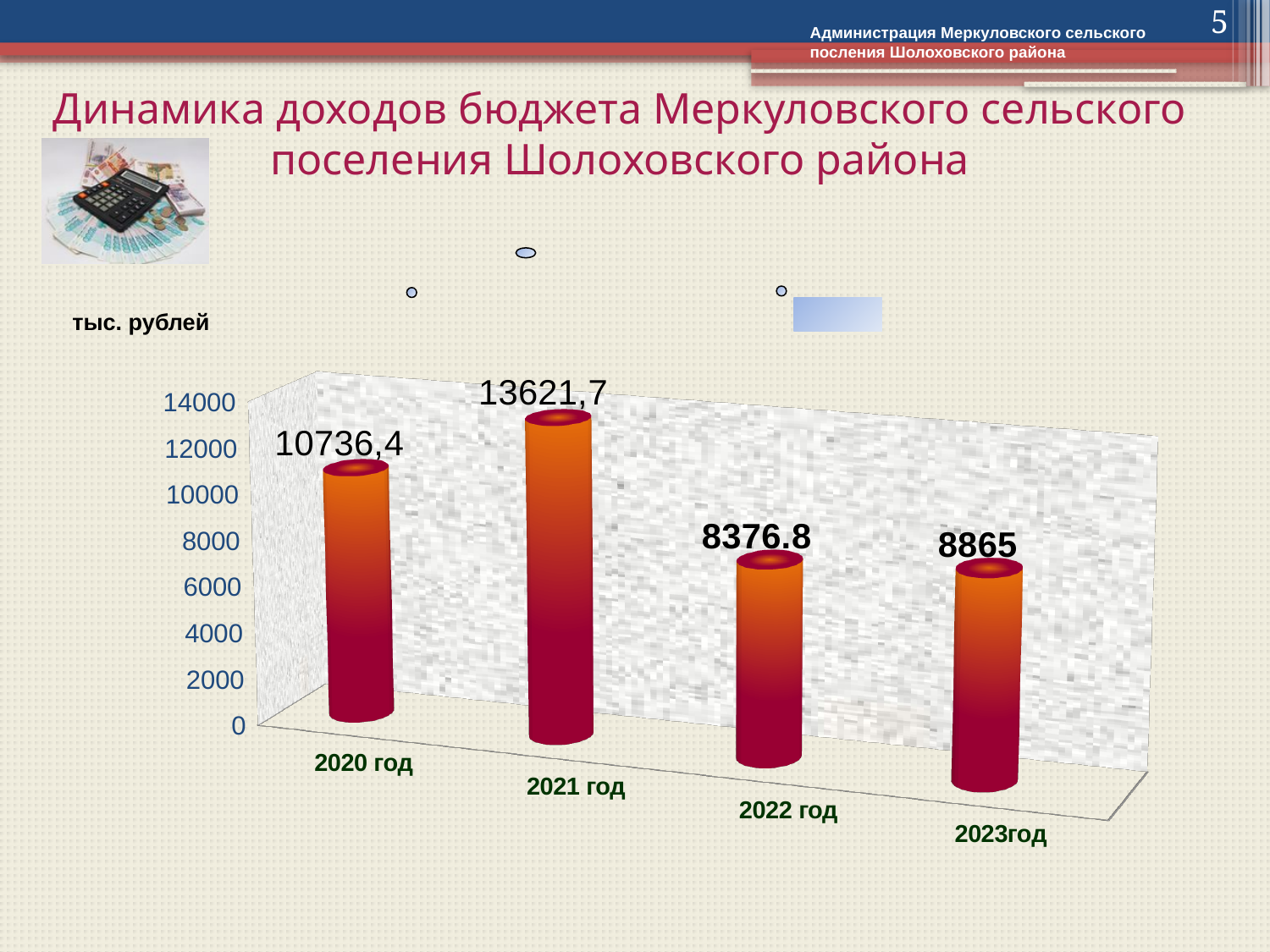
What kind of chart is shown on the slide? bar chart What is the difference between the values for 2021 год and 2020 год? 2885,3 What is the budget income value for 2023год? 8865 What is the budget income value for 2021 год? 13621,7 What is the budget income value for 2022 год? 8376.8 In what units are the values on the chart expressed? тыс. рублей Which year has the lowest budget income? 2022 год Which is larger, the value for 2020 год or the value for 2023год? 2020 год How many years are shown on the chart? 4 What is the budget income value for 2020 год? 10736,4 Is the value for 2022 год greater or less than 10000? less Which year has the highest budget income? 2021 год